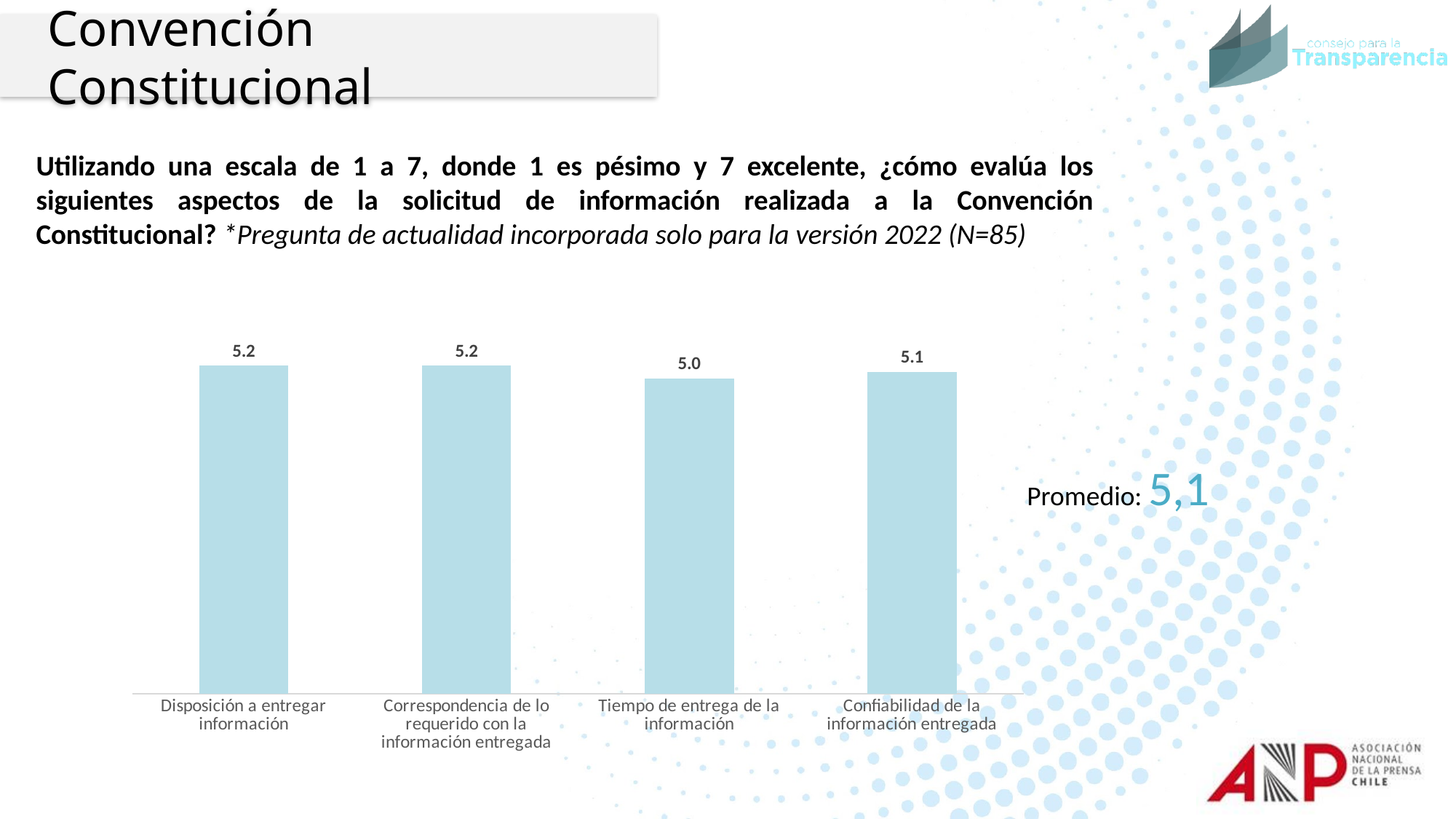
What is the sample size (N) stated in the question text above the chart? 85 What is the value for "Confiabilidad de la información entregada"? 5.1 What is the average (Promedio) shown next to the chart? 5,1 Which is larger, the value for "Confiabilidad de la información entregada" or the value for "Tiempo de entrega de la información"? Confiabilidad de la información entregada What is the difference between the values for "Disposición a entregar información" and "Tiempo de entrega de la información"? 0.2 What is the value for "Disposición a entregar información"? 5.2 How many categories are shown in the chart? 4 What is the value for "Tiempo de entrega de la información"? 5.0 Which category has the lowest value? Tiempo de entrega de la información What kind of chart is shown on the slide? Bar chart What is the value for "Correspondencia de lo requerido con la información entregada"? 5.2 What is the difference between the values for "Confiabilidad de la información entregada" and "Tiempo de entrega de la información"? 0.1